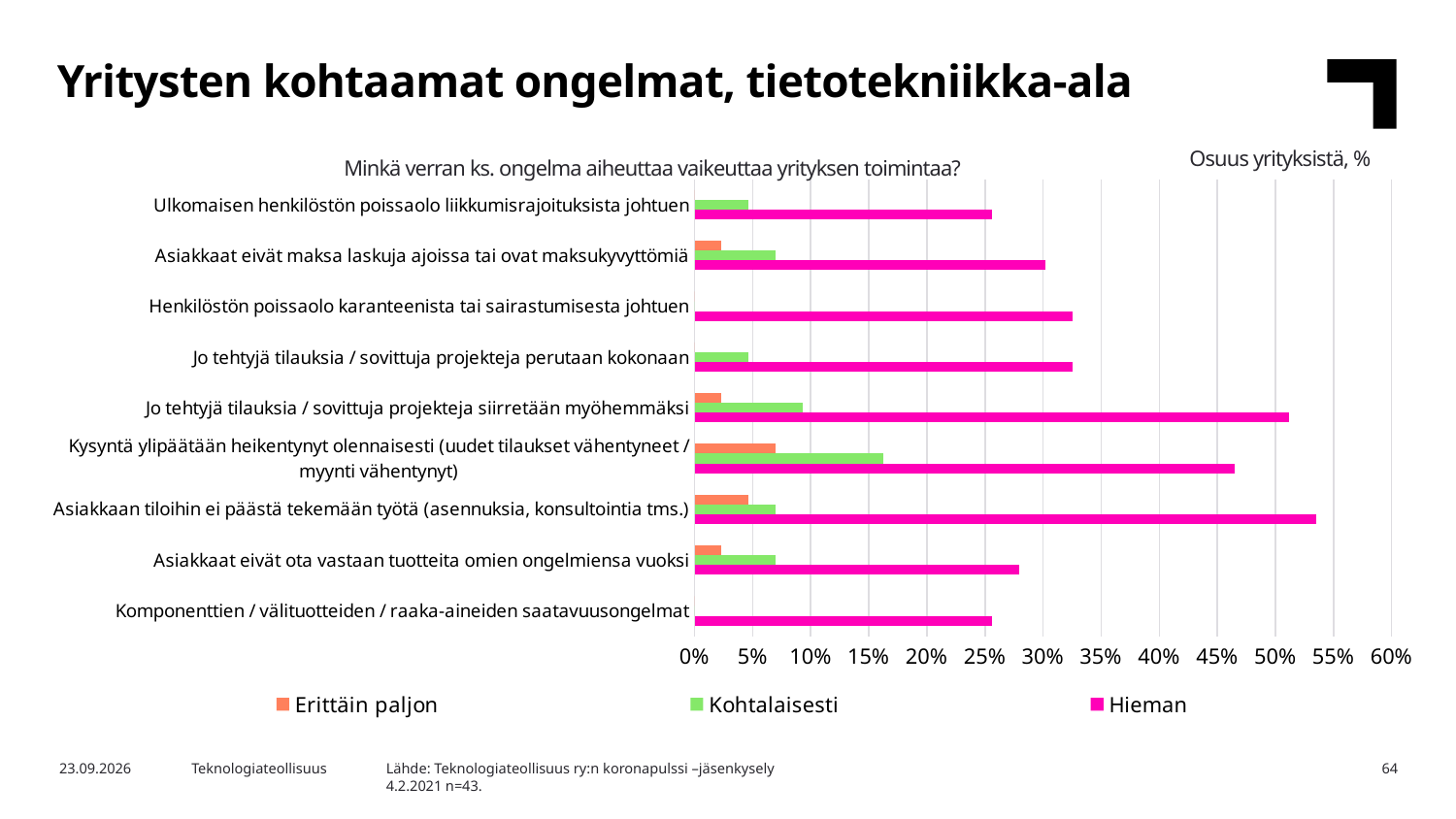
What is the title of the chart? Minkä verran ks. ongelma aiheuttaa vaikeuttaa yrityksen toimintaa? Which colour represents the 'Hieman' series in the legend? Magenta (pink) Which category has the highest value for the 'Erittäin paljon' series? Kysyntä ylipäätään heikentynyt olennaisesti (uudet tilaukset vähentyneet / myynti vähentynyt) Which has the larger 'Hieman' value: 'Asiakkaat eivät maksa laskuja ajoissa tai ovat maksukyvyttömiä' or 'Ulkomaisen henkilöstön poissaolo liikkumisrajoituksista johtuen'? Asiakkaat eivät maksa laskuja ajoissa tai ovat maksukyvyttömiä Is the 'Hieman' value for 'Henkilöstön poissaolo karanteenista tai sairastumisesta johtuen' greater or less than 30%? greater Is the 'Hieman' value for 'Jo tehtyjä tilauksia / sovittuja projekteja siirretään myöhemmäksi' greater or less than 45%? greater Is the 'Hieman' value for 'Asiakkaat eivät ota vastaan tuotteita omien ongelmiensa vuoksi' greater or less than 30%? less How many problem categories are plotted on the chart? 9 What kind of chart is shown on the slide? Bar chart Which category has the highest value for the 'Kohtalaisesti' series? Kysyntä ylipäätään heikentynyt olennaisesti (uudet tilaukset vähentyneet / myynti vähentynyt) How many series does the legend list? 3